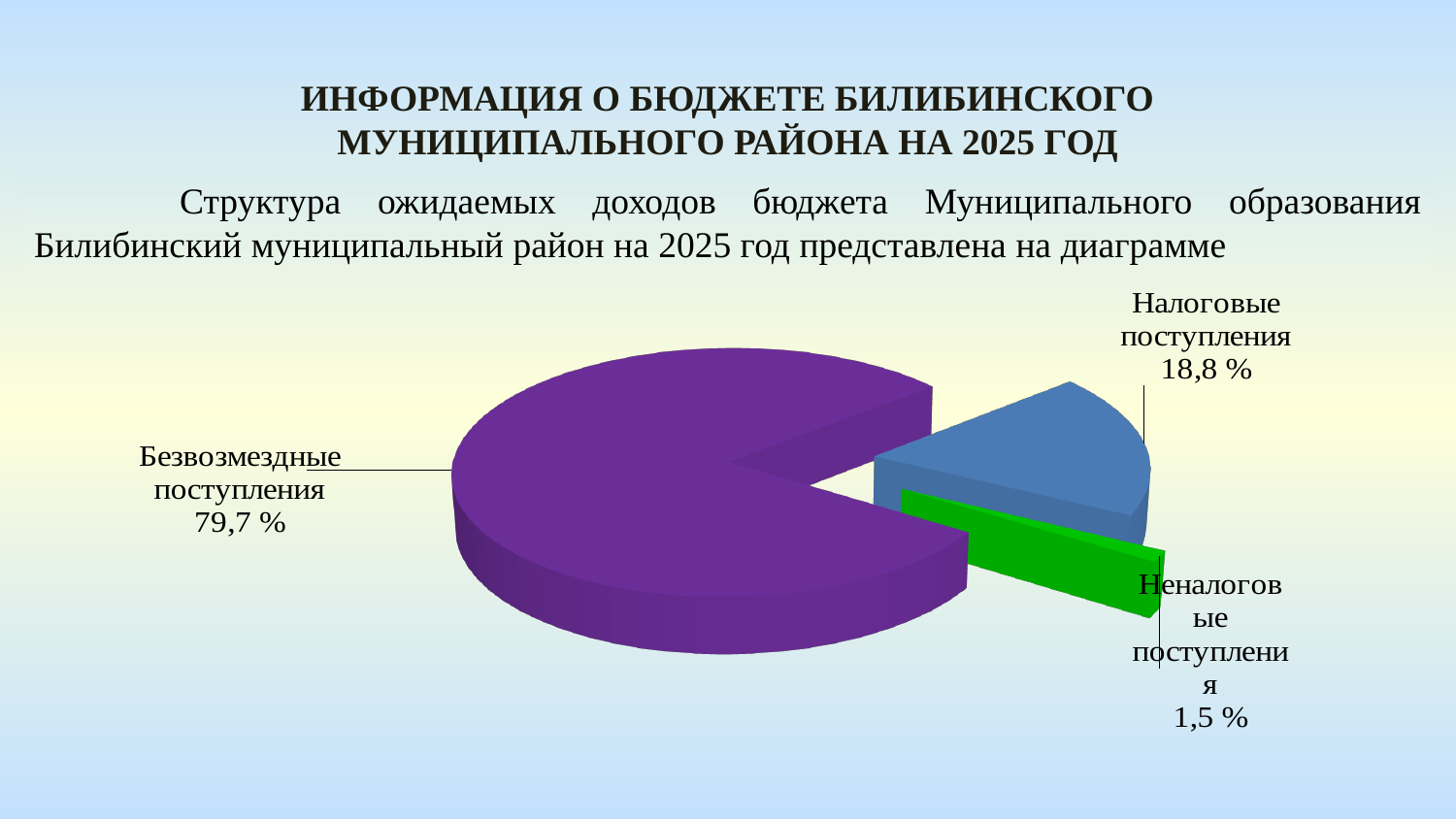
Which category has the largest slice of the pie? Безвозмездные поступления What colour is the slice for Безвозмездные поступления? Purple Which category has the smallest slice of the pie? Неналоговые поступления What colour is the slice for Неналоговые поступления? Green How many slices does the pie chart have? 3 What is the difference in percentage points between Безвозмездные поступления and Налоговые поступления? 60,9 What share of the pie does Безвозмездные поступления have? 79,7 % Which is larger: Налоговые поступления or Неналоговые поступления? Налоговые поступления What share of the pie does Неналоговые поступления have? 1,5 % What is the difference in percentage points between Налоговые поступления and Неналоговые поступления? 17,3 What share of the pie does Налоговые поступления have? 18,8 % What kind of chart is shown on the slide? Pie chart